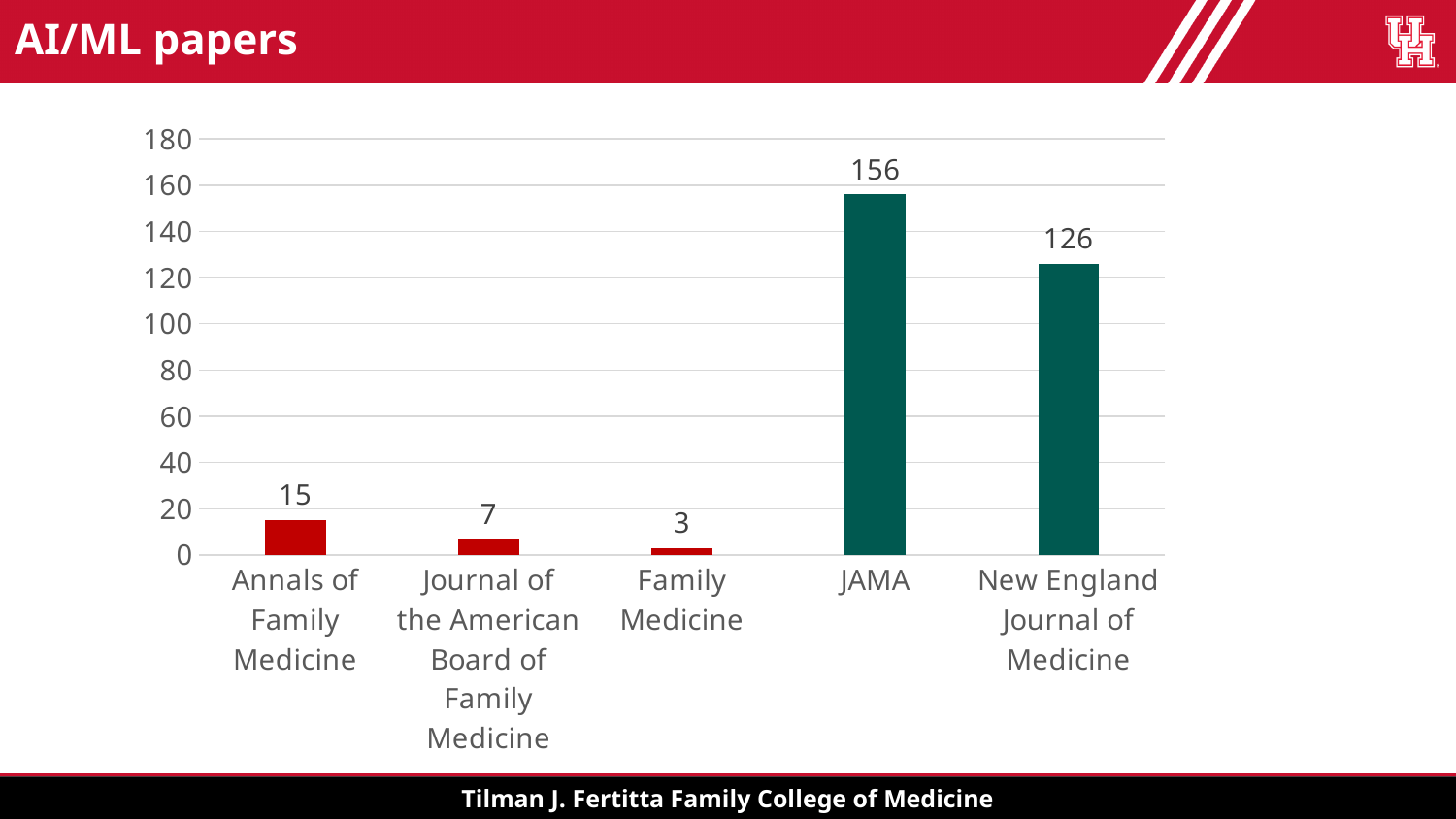
What is the title of the slide containing the chart? AI/ML papers How many categories are shown on the x axis? 5 What is the value for Annals of Family Medicine? 15 Which is larger, the value for Annals of Family Medicine or the value for Family Medicine? Annals of Family Medicine Which category has the highest value? JAMA What is the difference between the values for JAMA and New England Journal of Medicine? 30 What is the value for Journal of the American Board of Family Medicine? 7 Is the value for JAMA greater or less than 140? greater What is the value for JAMA? 156 Which category has the lowest value? Family Medicine What is the value for New England Journal of Medicine? 126 What kind of chart is shown on the slide? bar chart